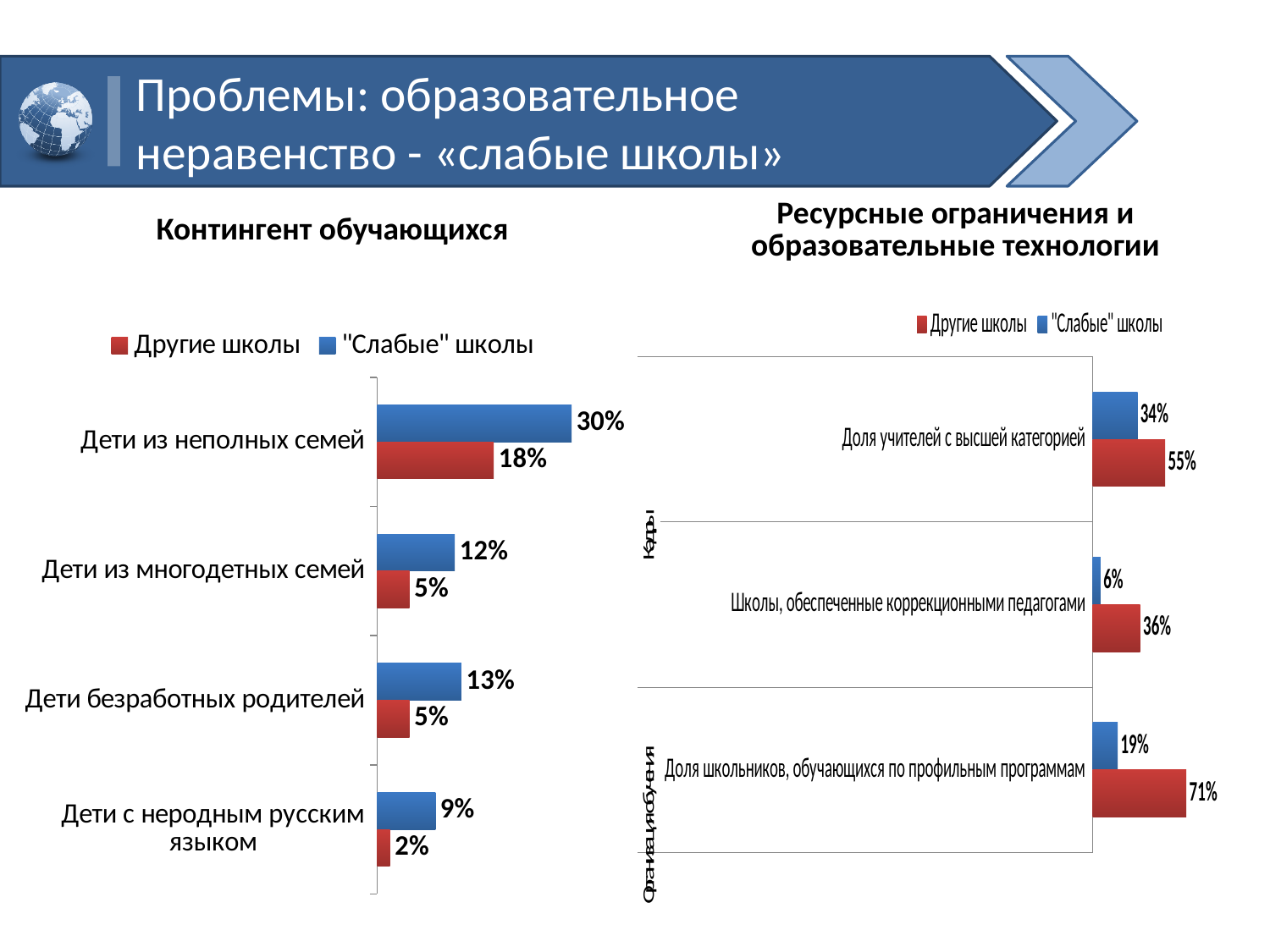
In the chart titled "Контингент обучающихся", how many categories are shown? 4 In the chart titled "Контингент обучающихся", what is the value for Другие школы in the category "Дети с неродным русским языком"? 2% In the chart titled "Контингент обучающихся", which category has the highest value for "Слабые" школы? Дети из неполных семей In the chart titled "Ресурсные ограничения и образовательные технологии", what is the difference between Другие школы and "Слабые" школы for "Доля школьников, обучающихся по профильным программам"? 52% In the chart titled "Контингент обучающихся", what is the value for "Слабые" школы in the category "Дети из неполных семей"? 30% How many series does the legend of the chart titled "Ресурсные ограничения и образовательные технологии" list? 2 In the chart titled "Ресурсные ограничения и образовательные технологии", what is the value for "Слабые" школы in "Школы, обеспеченные коррекционными педагогами"? 6% In the chart titled "Ресурсные ограничения и образовательные технологии", which is larger for "Доля учителей с высшей категорией": Другие школы or "Слабые" школы? Другие школы What type of chart is the chart titled "Контингент обучающихся"? Bar chart In the chart titled "Ресурсные ограничения и образовательные технологии", what is the value for Другие школы in "Доля школьников, обучающихся по профильным программам"? 71% In the chart titled "Контингент обучающихся", what is the difference between the "Слабые" школы and Другие школы values for "Дети из неполных семей"? 12% In the chart titled "Контингент обучающихся", which category has the lowest value for Другие школы? Дети с неродным русским языком